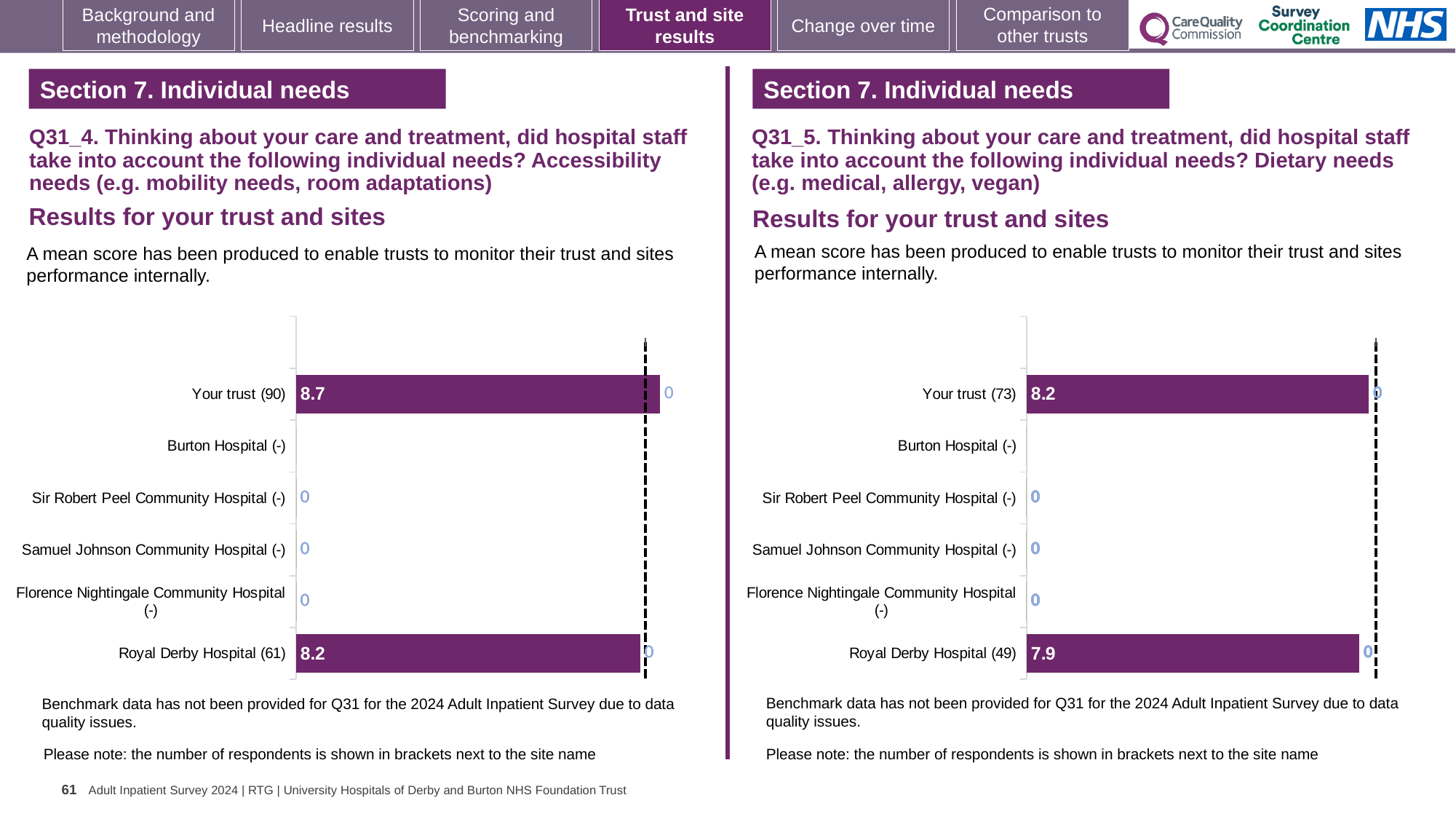
How many site categories are listed on the y axis of the Q31_4 Accessibility needs chart on the left? 6 In the Q31_5 Dietary needs chart on the right, what is the difference between the Your trust score and the Royal Derby Hospital score? 0.3 In the Q31_4 Accessibility needs chart on the left, what is the mean score for Your trust? 8.7 In the Q31_4 Accessibility needs chart on the left, which has the higher score, Your trust or Royal Derby Hospital? Your trust In the Q31_5 Dietary needs chart on the right, which has the higher score, Your trust or Royal Derby Hospital? Your trust In the Q31_5 Dietary needs chart on the right, what is the mean score for Royal Derby Hospital? 7.9 In the Q31_4 Accessibility needs chart on the left, how many respondents are shown in brackets for Royal Derby Hospital? 61 In the Q31_5 Dietary needs chart on the right, how many respondents are shown in brackets for Your trust? 73 In the Q31_5 Dietary needs chart on the right, what is the mean score for Your trust? 8.2 In the Q31_4 Accessibility needs chart on the left, what is the mean score for Royal Derby Hospital? 8.2 What type of chart is used for the Q31_5 Dietary needs results on the right? Bar chart In the Q31_4 Accessibility needs chart on the left, what is the difference between the Your trust score and the Royal Derby Hospital score? 0.5